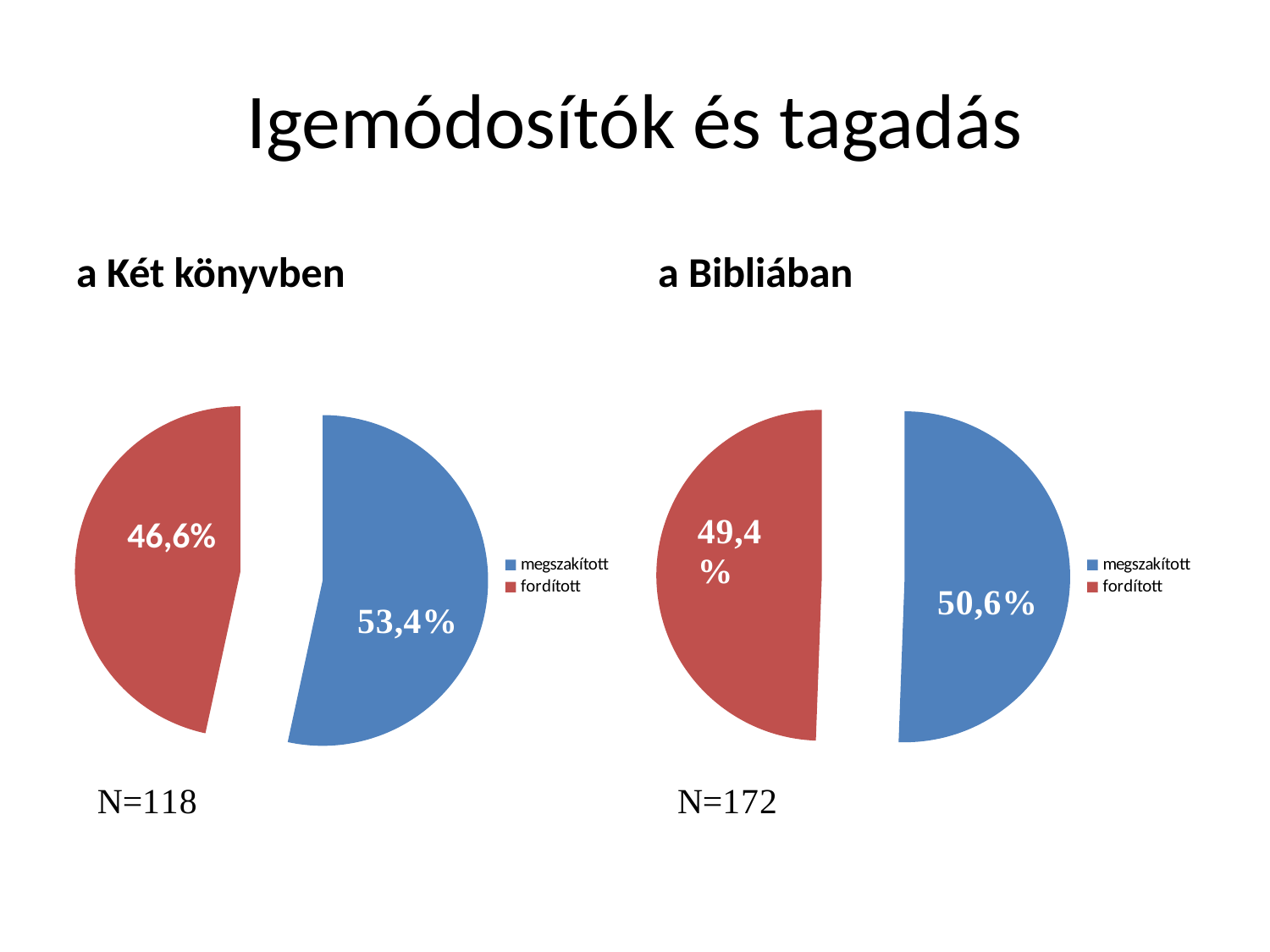
In the chart titled "a Két könyvben", what share does the "fordított" slice have? 46,6% How many slices does the chart titled "a Bibliában" have? 2 In the chart titled "a Bibliában", what share does the "megszakított" slice have? 50,6% In the chart titled "a Két könyvben", what share does the "megszakított" slice have? 53,4% In the chart titled "a Két könyvben", what colour is the "fordított" slice? red What sample size (N) is shown below the chart titled "a Bibliában"? N=172 In the chart titled "a Bibliában", which slice is larger, "megszakított" or "fordított"? megszakított In the chart titled "a Bibliában", which category has the smallest slice? fordított In the chart titled "a Két könyvben", which category has the largest slice? megszakított What kind of chart is the chart titled "a Két könyvben"? pie chart In the chart titled "a Két könyvben", what is the difference in percentage points between the "megszakított" and "fordított" slices? 6,8